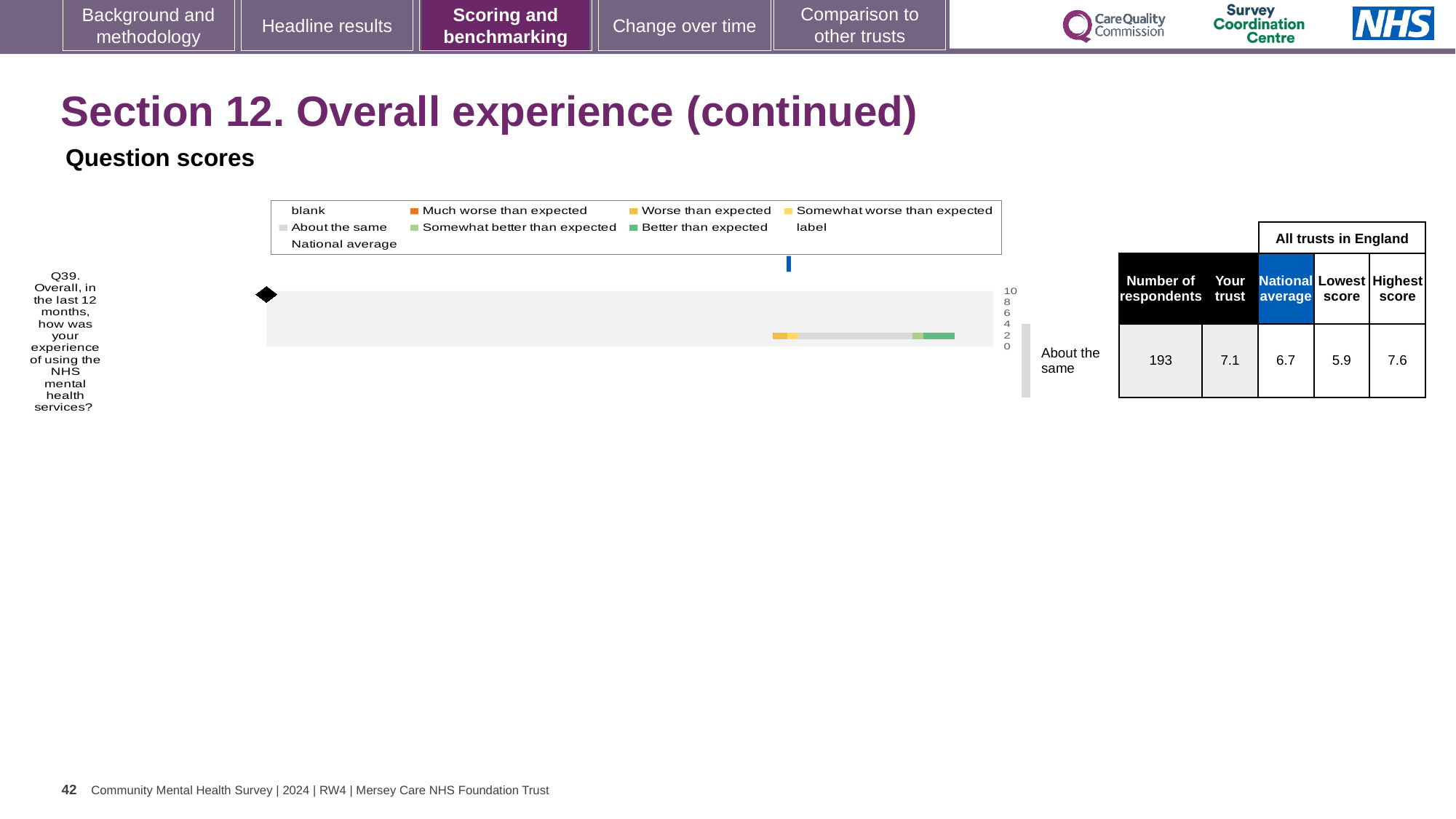
In the table beside the chart, what is the number of respondents for Q39? 193 What kind of chart is shown on the slide for Q39? bar chart In the table beside the chart, what is the lowest score among all trusts in England for Q39? 5.9 What is the difference between the 'Your trust' score and the national average for Q39? 0.4 What benchmark category label is shown next to the bar for Q39? About the same Which is larger for Q39, the 'Your trust' score or the national average? Your trust In the table beside the chart, what is the 'Your trust' score for Q39? 7.1 In the table beside the chart, what is the national average score for Q39? 6.7 Which question is plotted in the chart on the slide? Q39. Overall, in the last 12 months, how was your experience of using the NHS mental health services? What colour does the legend use for 'Better than expected'? green In the table beside the chart, what is the highest score among all trusts in England for Q39? 7.6 What is the difference between the highest and lowest scores among all trusts in England for Q39? 1.7